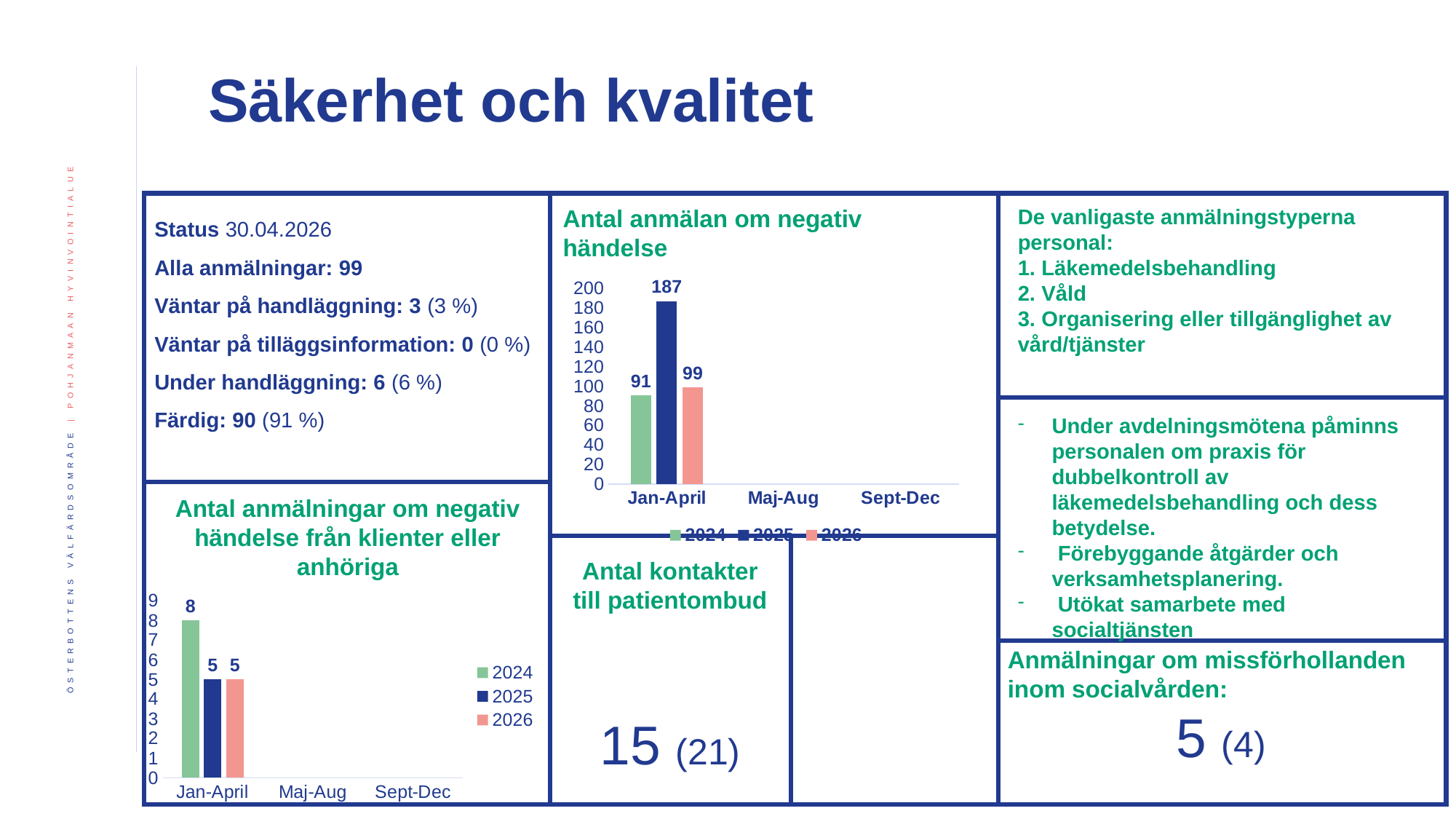
In the chart 'Antal anmälningar om negativ händelse från klienter eller anhöriga', what is the difference between the 2024 and 2025 values in Jan-April? 3 In the chart 'Antal anmälningar om negativ händelse från klienter eller anhöriga', what is the value for 2024 in Jan-April? 8 In the chart 'Antal anmälan om negativ händelse', how many series does the legend list? 3 In the chart 'Antal anmälan om negativ händelse', what is the difference between the 2025 and 2024 values in Jan-April? 96 What kind of chart is 'Antal anmälningar om negativ händelse från klienter eller anhöriga'? Bar chart In the chart 'Antal anmälningar om negativ händelse från klienter eller anhöriga', what is the value for 2026 in Jan-April? 5 In the chart 'Antal anmälningar om negativ händelse från klienter eller anhöriga', which series has the highest value in Jan-April? 2024 In the chart 'Antal anmälan om negativ händelse', what is the value for 2024 in Jan-April? 91 In the chart 'Antal anmälan om negativ händelse', which series has the highest value in Jan-April? 2025 In the chart 'Antal anmälan om negativ händelse', what is the value for 2025 in Jan-April? 187 In the chart 'Antal anmälan om negativ händelse', how many categories are shown on the x axis? 3 In the chart 'Antal anmälan om negativ händelse', what is the value for 2026 in Jan-April? 99